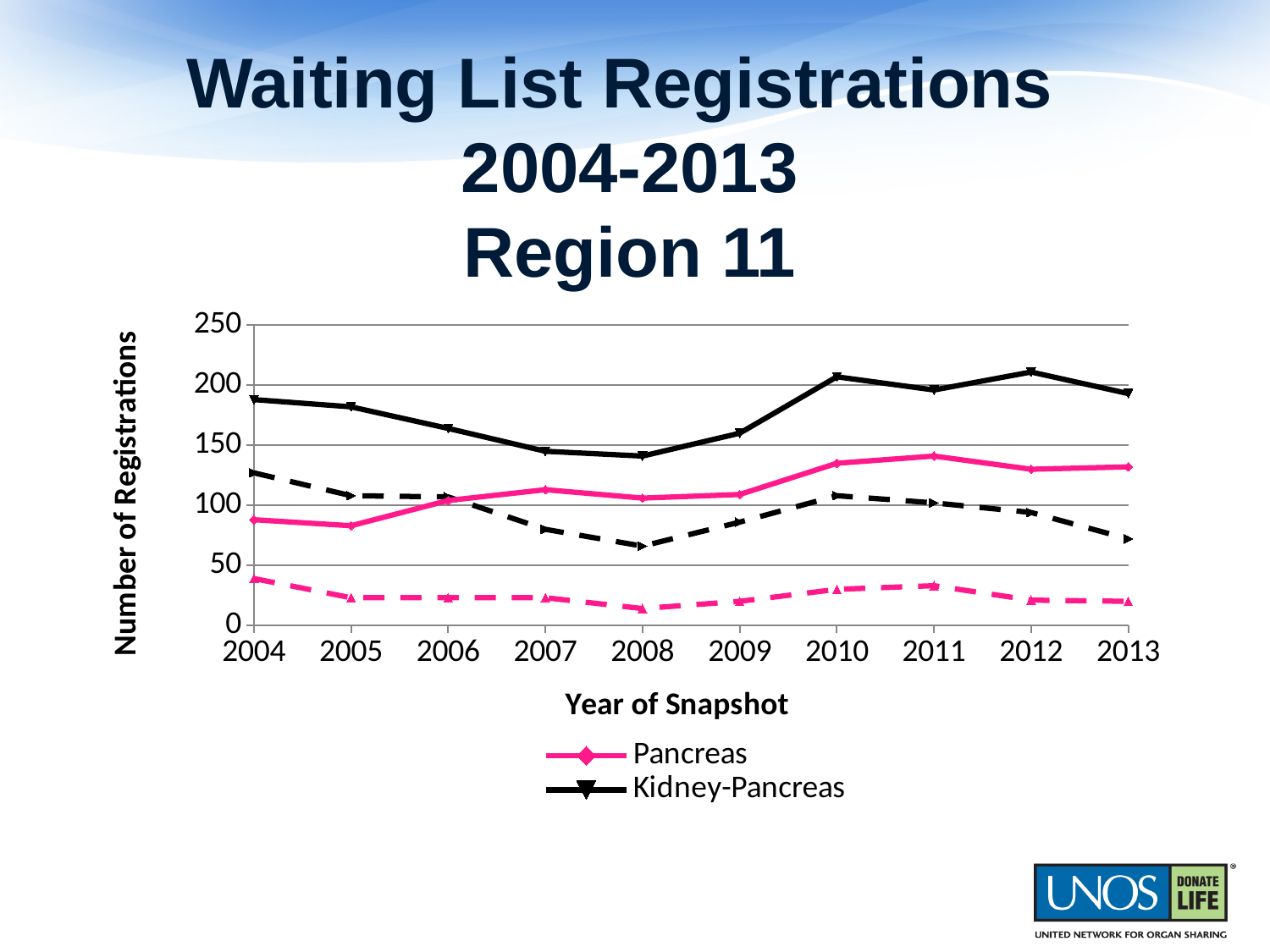
What is the title of the x axis? Year of Snapshot Is the Kidney-Pancreas value for 2012 greater or less than 200? greater In 2013, which series has the higher value, Pancreas or Kidney-Pancreas? Kidney-Pancreas How many years are shown on the x axis? 10 Is the Kidney-Pancreas value for 2008 greater or less than 150? less Which is larger for Pancreas: the value in 2005 or the value in 2010? 2010 Is the Pancreas value for 2011 greater or less than 150? less Which is larger for Kidney-Pancreas: the value in 2004 or the value in 2008? 2004 What kind of chart is shown on the slide? line chart Does the Kidney-Pancreas line rise or fall from 2004 to 2008? fall How many series does the legend list? 2